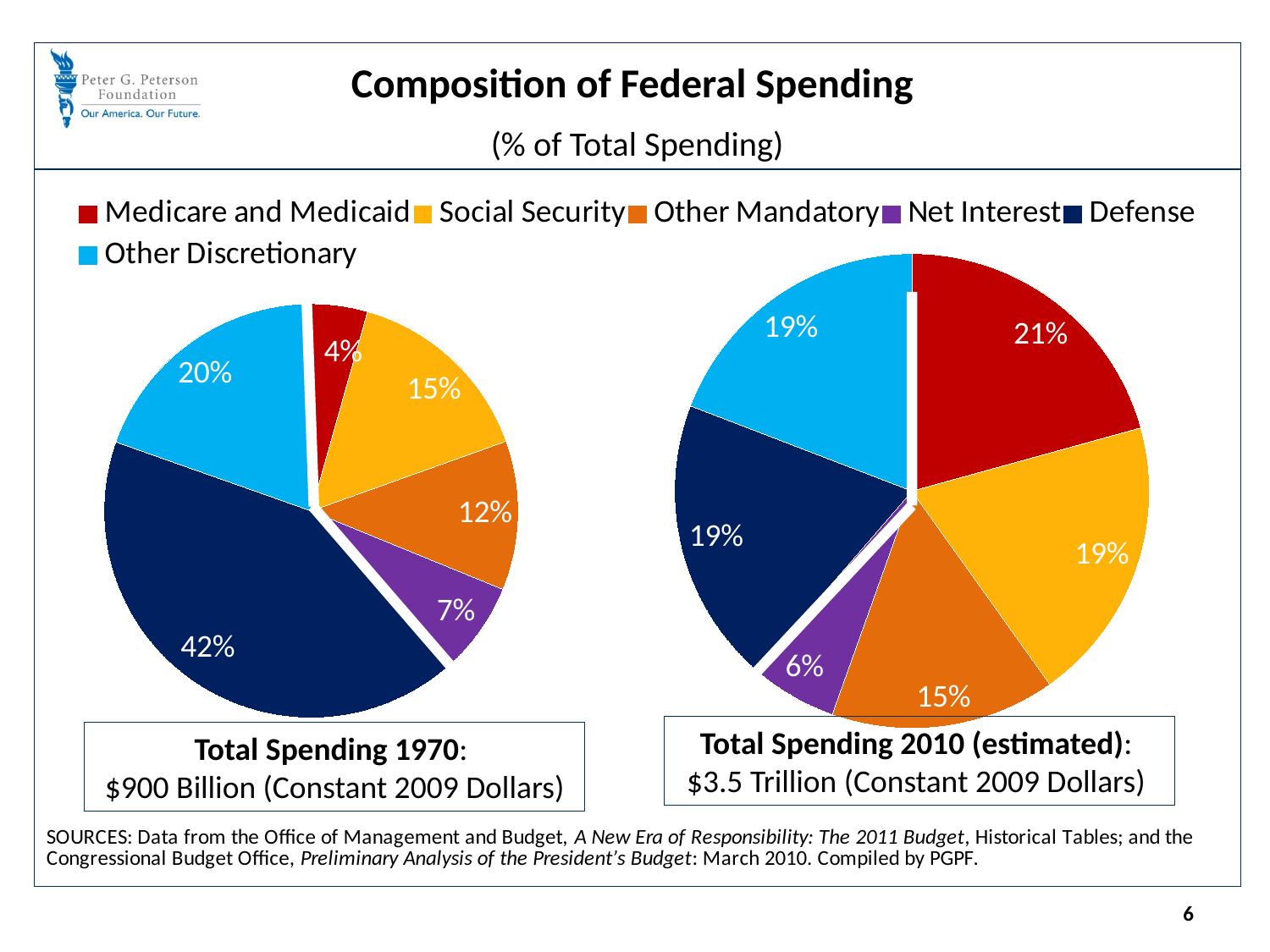
In the Total Spending 1970 pie chart, what share of spending is Defense? 42% What type of chart is used to show the composition of federal spending on this slide? Pie chart In the Total Spending 1970 pie chart, which category has the smallest share? Medicare and Medicaid How many categories does the legend list for the pie charts? 6 In the Total Spending 2010 (estimated) pie chart, which category has the largest share? Medicare and Medicaid In the Total Spending 2010 (estimated) pie chart, what share of spending is Other Mandatory? 15% In the Total Spending 1970 pie chart, what share of spending is Net Interest? 7% In the Total Spending 1970 pie chart, which is larger: the Social Security share or the Other Mandatory share? Social Security In the Total Spending 2010 (estimated) pie chart, which category has the smallest share? Net Interest In the Total Spending 1970 pie chart, which category has the largest share? Defense In the Total Spending 2010 (estimated) pie chart, what share of spending is Medicare and Medicaid? 21% What is the difference in percentage points between the Defense share in the 1970 pie chart and the Defense share in the 2010 (estimated) pie chart? 23